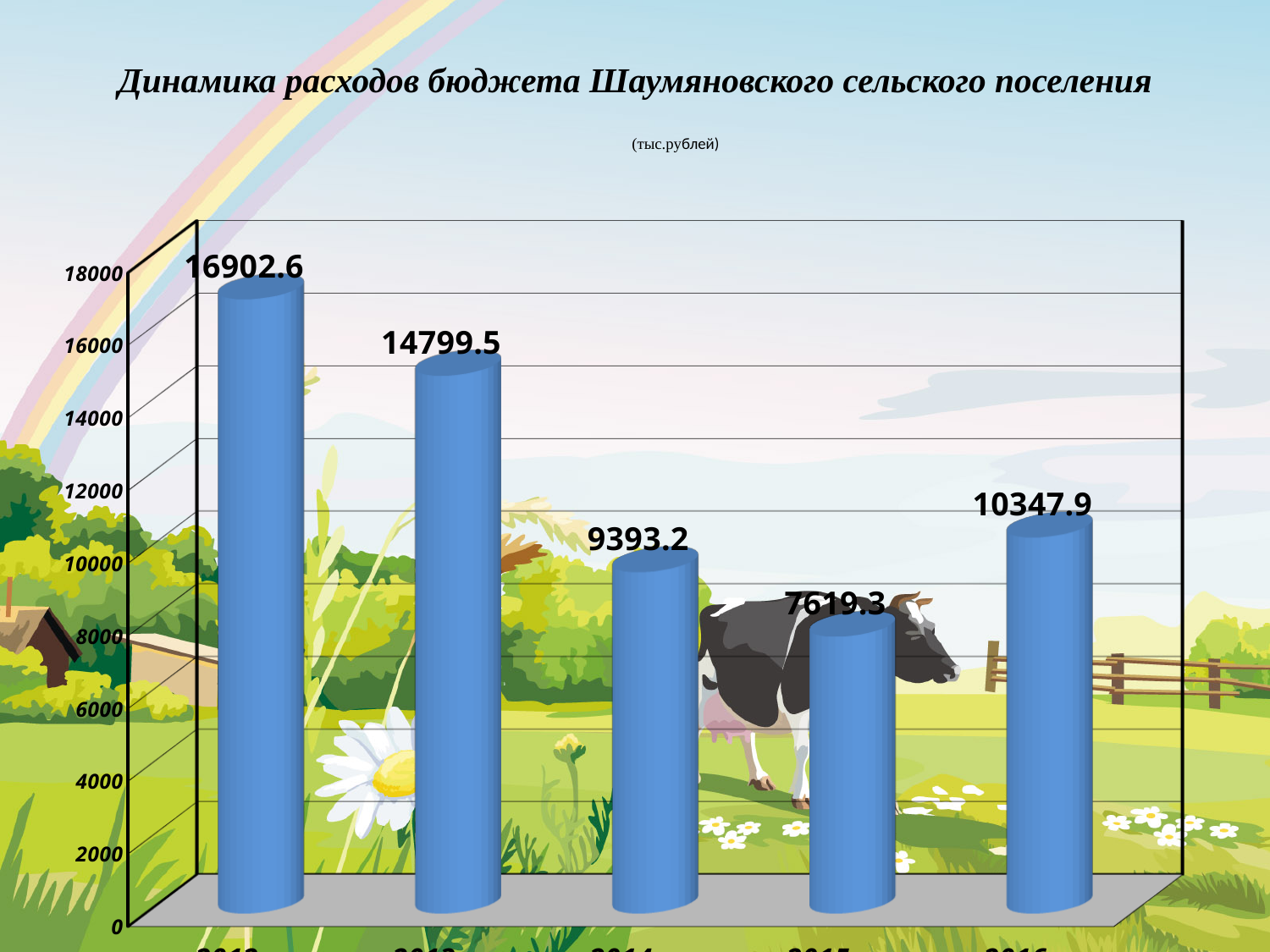
Is the value of the third bar greater or less than 10000? less What is the difference between the last bar (10347.9) and the fourth bar (7619.3)? 2728.6 What is the value of the fourth bar from the left? 7619.3 Which is larger, the third bar or the fifth bar? The fifth bar (10347.9) What kind of chart is shown on the slide? Bar chart Which bar has the lowest value? The fourth bar, 7619.3 What is the difference between the first bar (16902.6) and the second bar (14799.5)? 2103.1 How many bars are shown in the chart? 5 Which bar has the highest value? The first (leftmost) bar, 16902.6 What is the value of the first (leftmost) bar? 16902.6 What is the value of the last (rightmost) bar? 10347.9 Do the values rise or fall from the first bar to the fourth bar? fall